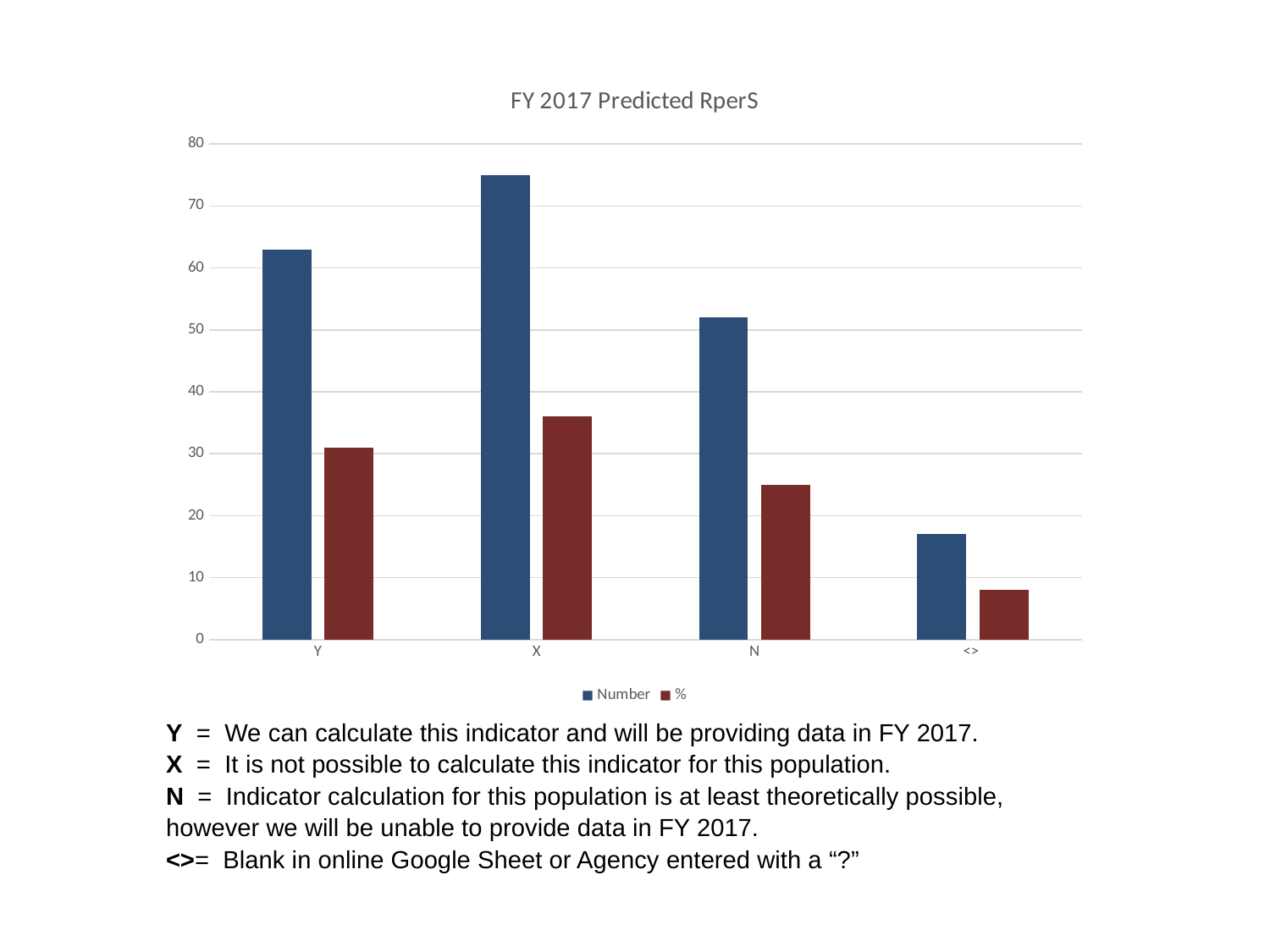
Which category has the lowest Number value? <> Is the Number value for X greater or less than 70? greater How many categories are shown on the x axis? 4 How many series does the legend list? 2 Which series is shown in dark red? % What is the title of the chart? FY 2017 Predicted RperS Which category has the highest Number value? X Which is larger, the Number value for Y or the Number value for N? Y Which category has the lowest % value? <> What type of chart is shown on the slide? bar chart Is the Number value for <> greater or less than 20? less